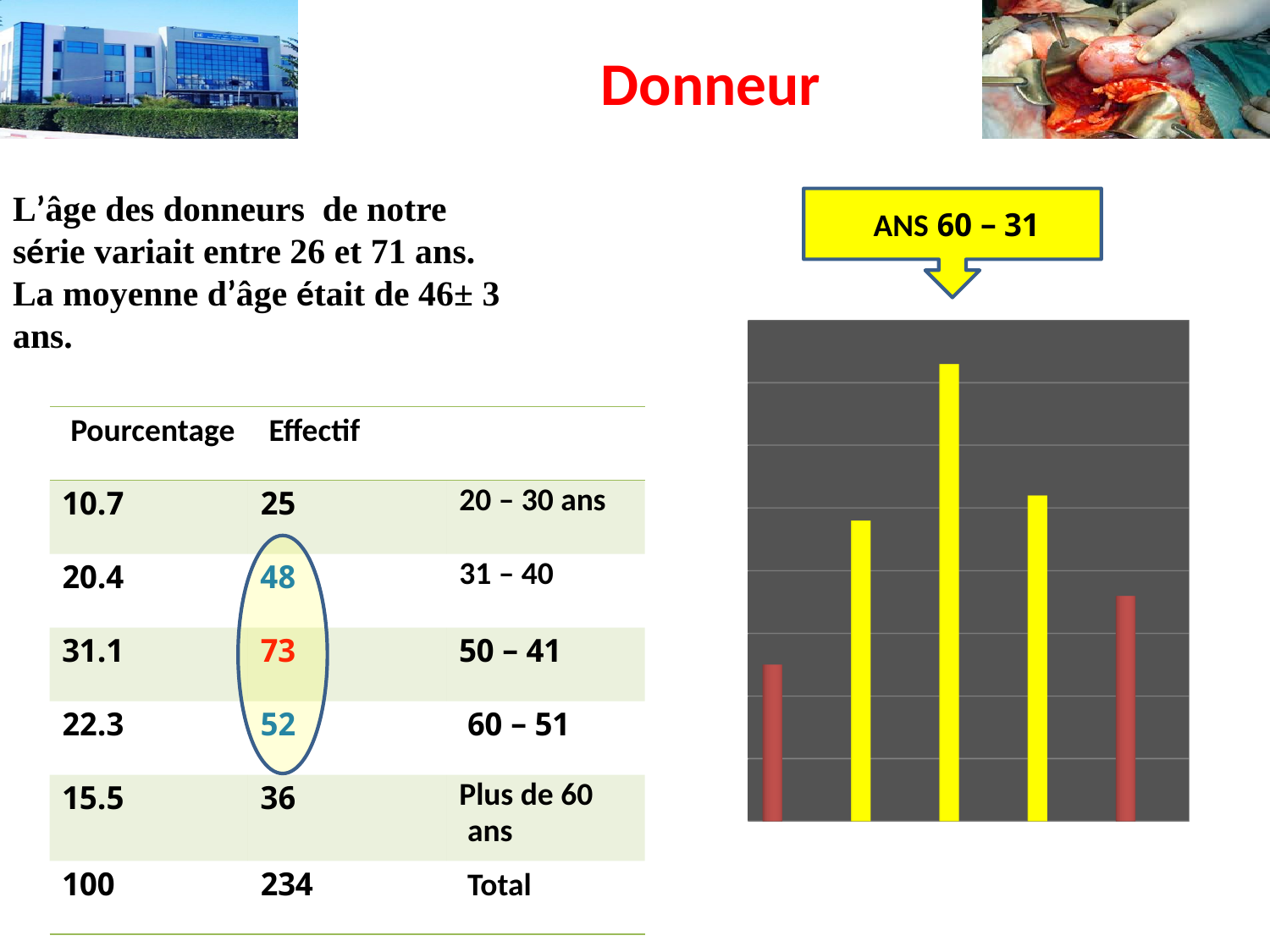
Do the bar heights in the chart on the right rise or fall from the first bar to the third bar? rise How many bars in the chart on the right are coloured yellow? 3 In the chart on the right, is the second bar or the fourth bar taller? the fourth bar Which bar in the chart on the right is the shortest? the first bar What kind of chart is shown on the right side of the slide? bar chart What colour are the first and last bars in the chart on the right? red In the chart on the right, is the fifth bar or the first bar taller? the fifth bar Which bar in the chart on the right is the tallest? the third bar How many bars does the chart on the right side of the slide have? 5 Do the bar heights in the chart on the right rise or fall from the third bar to the fifth bar? fall